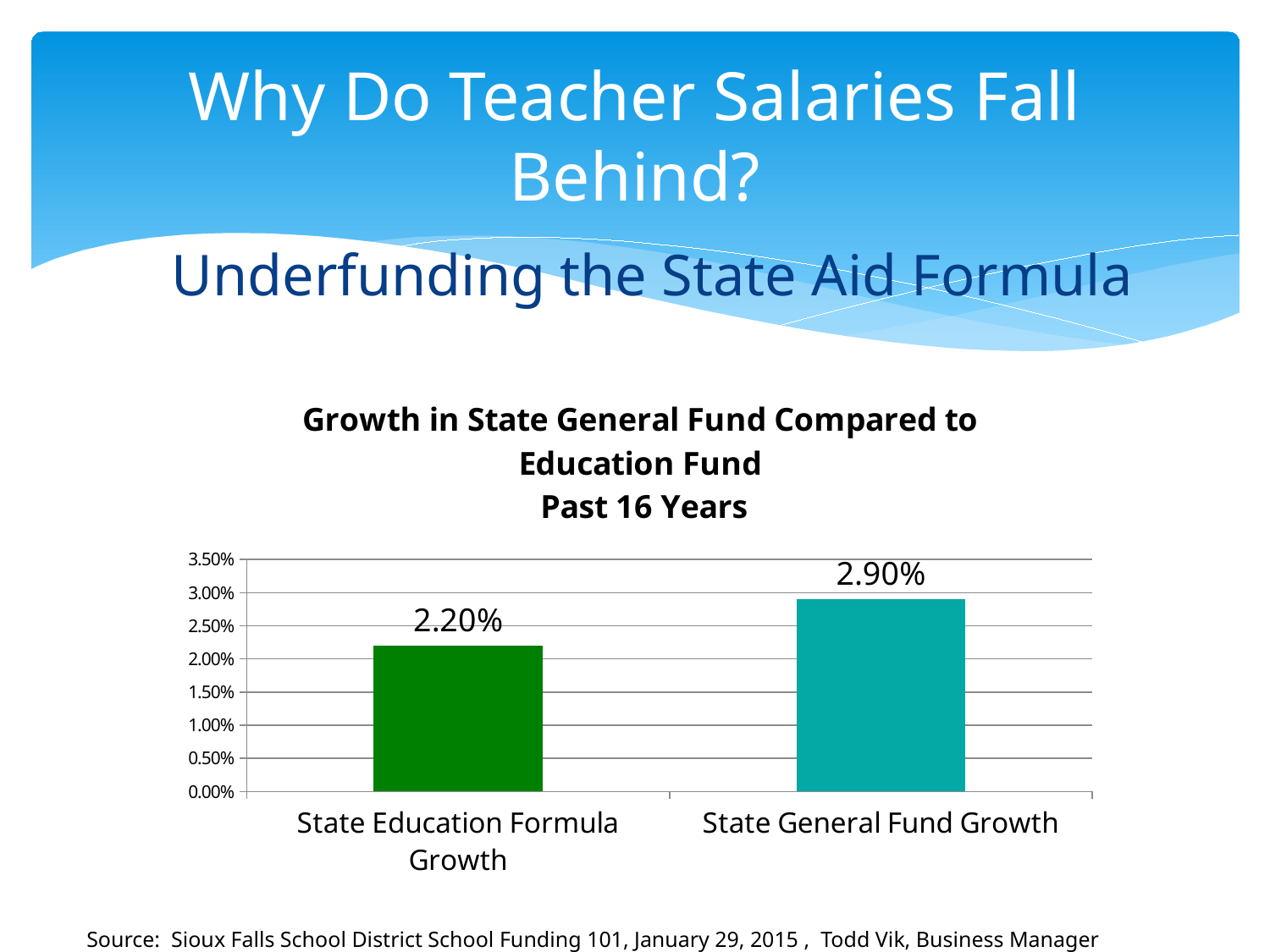
What is the value for State Education Formula Growth? 2.20% Is the value for State Education Formula Growth greater or less than 2.50%? less What is the difference between State General Fund Growth and State Education Formula Growth? 0.70% How many categories are shown in the chart? 2 What is the value for State General Fund Growth? 2.90% What is the highest value shown on the vertical axis? 3.50% Which is larger, State Education Formula Growth or State General Fund Growth? State General Fund Growth What is the title of the chart? Growth in State General Fund Compared to Education Fund Past 16 Years What kind of chart is shown on the slide? bar chart Which category has the highest value? State General Fund Growth Is the value for State General Fund Growth greater or less than 2.50%? greater Which category has the lowest value? State Education Formula Growth